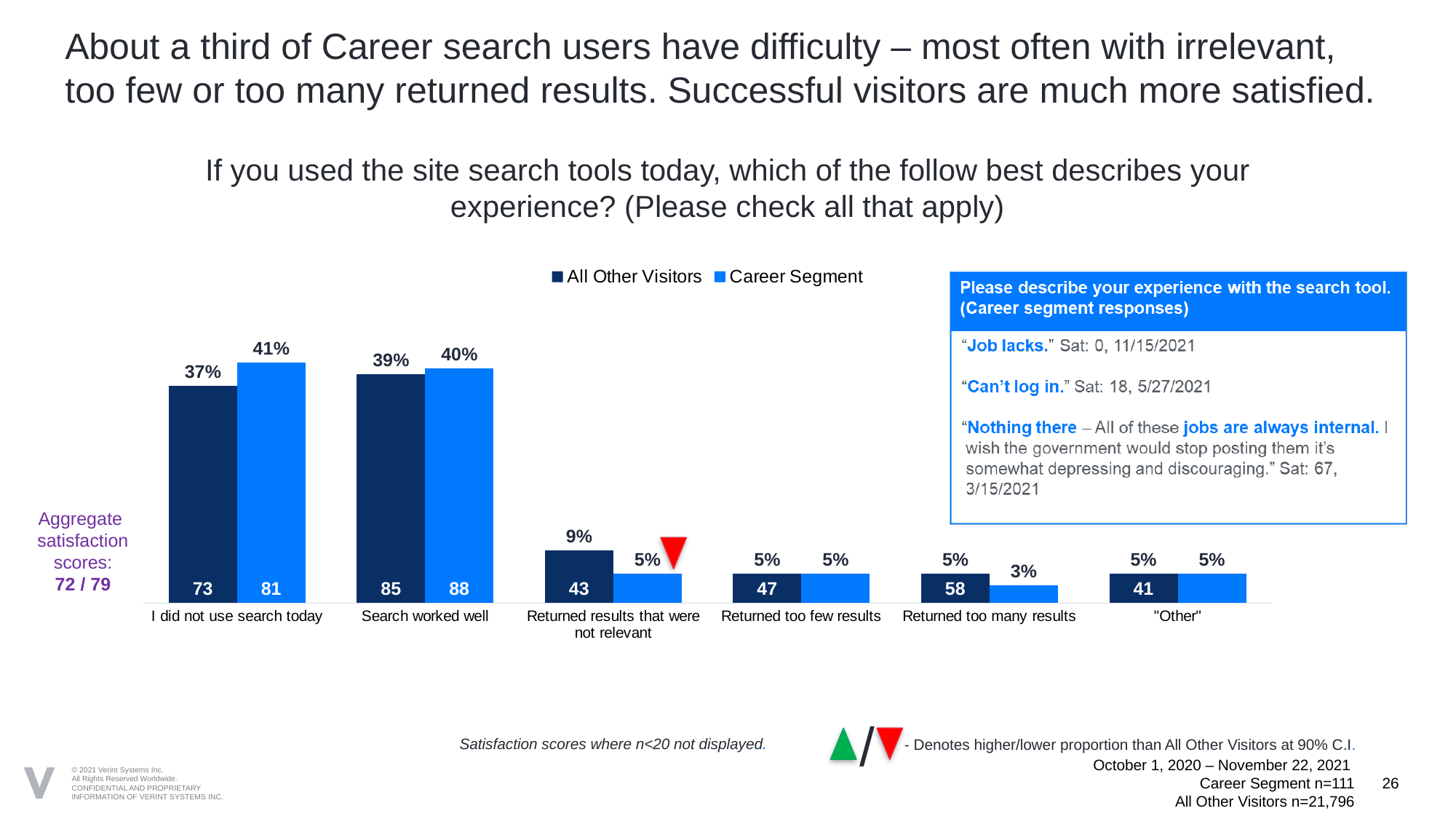
What is the difference between All Other Visitors and Career Segment for 'Returned results that were not relevant'? 4 percentage points What percentage of the Career Segment said 'I did not use search today'? 41% What percentage of the Career Segment reported 'Returned too many results'? 3% Which category has the highest value for All Other Visitors? Search worked well What type of chart is shown on the slide? Bar chart What percentage of the Career Segment reported 'Returned results that were not relevant'? 5% How many response categories are shown on the x axis? 6 Which category has the lowest value for the Career Segment? Returned too many results What percentage of All Other Visitors said 'Search worked well'? 39% What are the aggregate satisfaction scores shown to the left of the chart? 72 / 79 For 'I did not use search today', which series has the larger value, All Other Visitors or Career Segment? Career Segment How many series does the legend list? 2